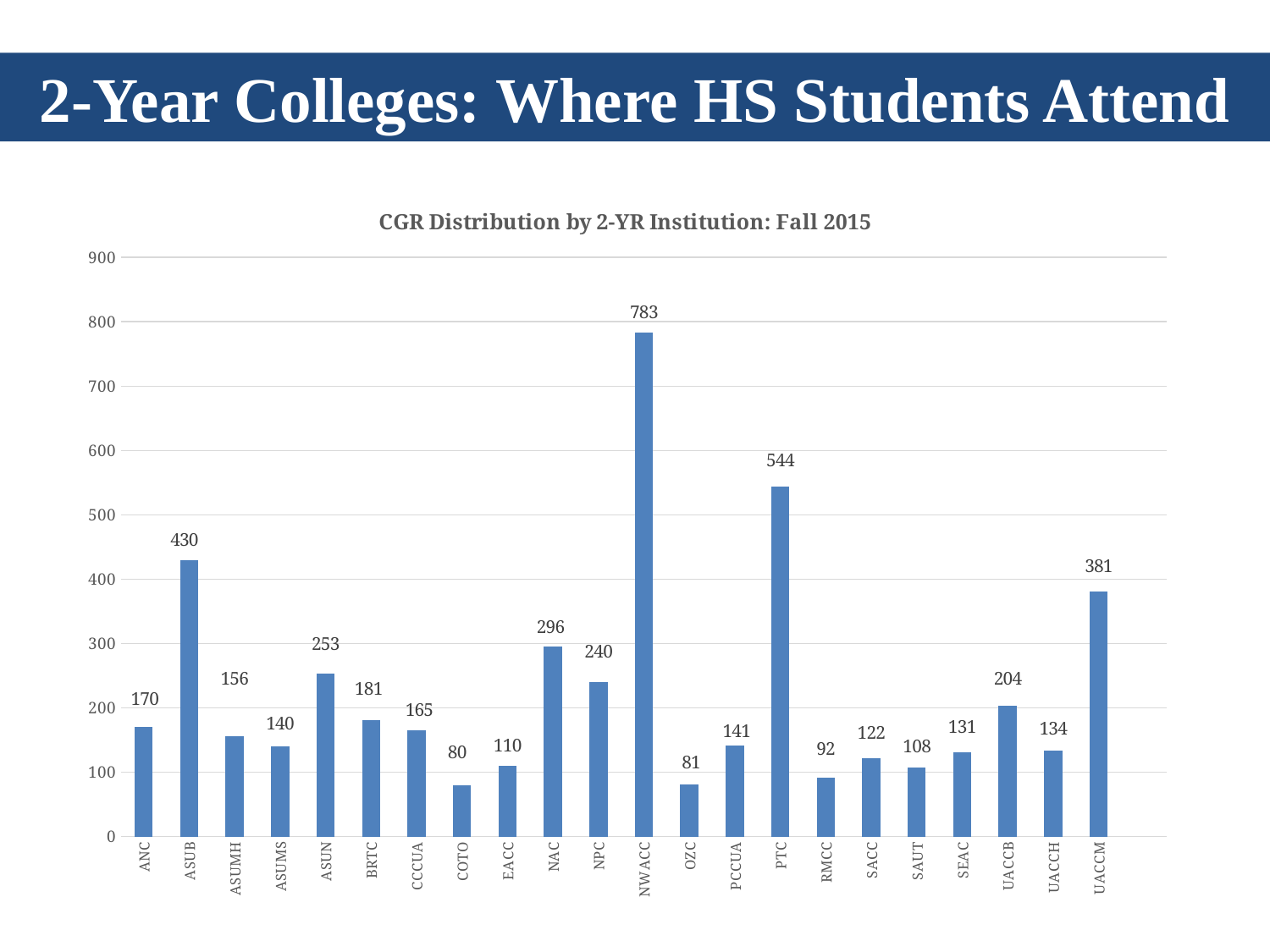
Which institution has the lowest value? COTO How many institutions are shown on the x axis? 22 What is the value for ASUB? 430 Which is larger, the value for NAC or the value for NPC? NAC What is the value for NWACC? 783 What is the difference between the values for ASUB and UACCM? 49 What kind of chart is shown on the slide? bar chart What is the difference between the values for NWACC and PTC? 239 Which institution has the highest value? NWACC Is the value for PTC greater or less than 500? greater What is the value for UACCM? 381 What is the title of the chart? CGR Distribution by 2-YR Institution: Fall 2015